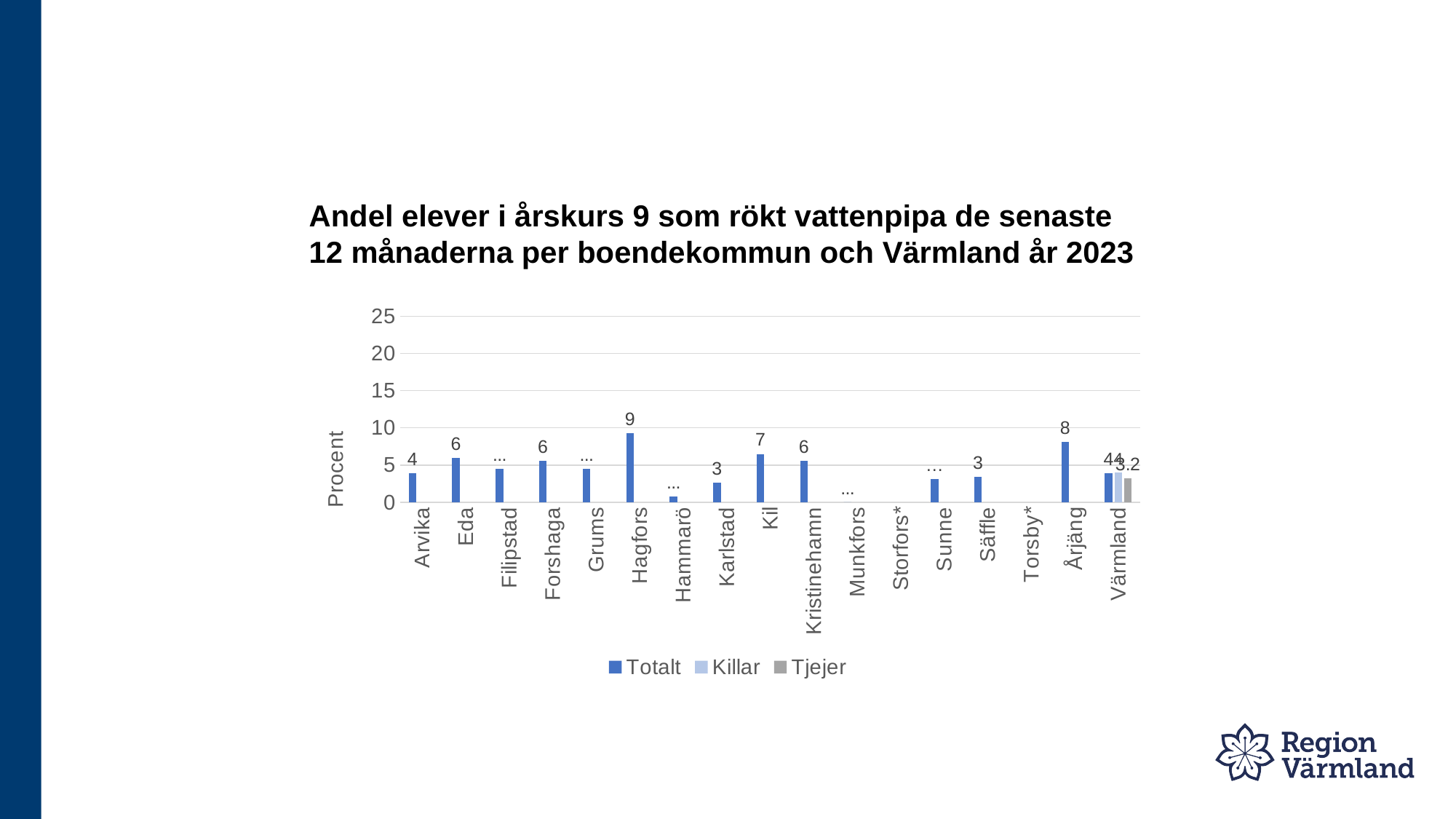
What is the Killar value for Värmland? 4 How many categories are shown on the x axis? 17 Is the Totalt value for Kil greater or less than 10? less How many series does the legend list? 3 What is the difference between the Totalt values for Årjäng and Säffle? 5 What kind of chart is shown on the slide? bar chart What is the Totalt value for Kil? 7 What is the Totalt value for Hagfors? 9 What is the difference between the Totalt values for Hagfors and Karlstad? 6 Which has a larger Totalt value, Eda or Karlstad? Eda Which municipality has the highest Totalt value? Hagfors What is the Tjejer value for Värmland? 3.2